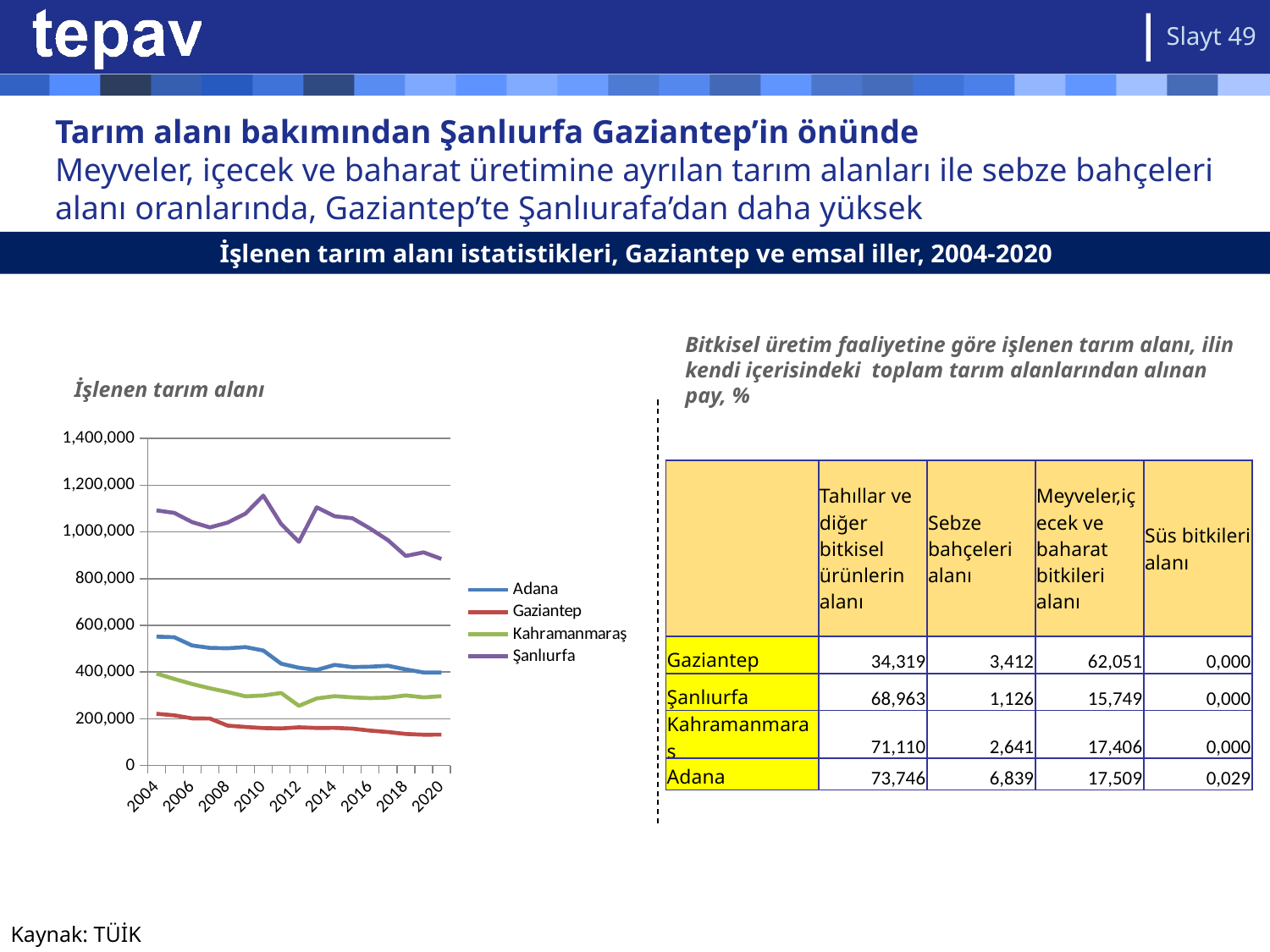
In the 'İşlenen tarım alanı' chart, is the value for Kahramanmaraş in 2020 greater or less than 400,000? less In the 'İşlenen tarım alanı' chart, is the value for Adana in 2004 greater or less than 400,000? greater In the 'İşlenen tarım alanı' chart, does the Adana series rise or fall from 2004 to 2020? fall What kind of chart is the 'İşlenen tarım alanı' chart? line chart How many series does the legend of the 'İşlenen tarım alanı' chart list? 4 What is the first year and the last year shown on the x axis of the 'İşlenen tarım alanı' chart? 2004 and 2020 In the 'İşlenen tarım alanı' chart, is the value for Gaziantep in 2020 greater or less than 200,000? less What is the highest value shown on the y axis of the 'İşlenen tarım alanı' chart? 1,400,000 Which series in the 'İşlenen tarım alanı' chart has the lowest values across the whole period? Gaziantep Which series in the 'İşlenen tarım alanı' chart has the highest values across the whole period? Şanlıurfa In the 'İşlenen tarım alanı' chart, which is larger in 2020, Adana or Kahramanmaraş? Adana